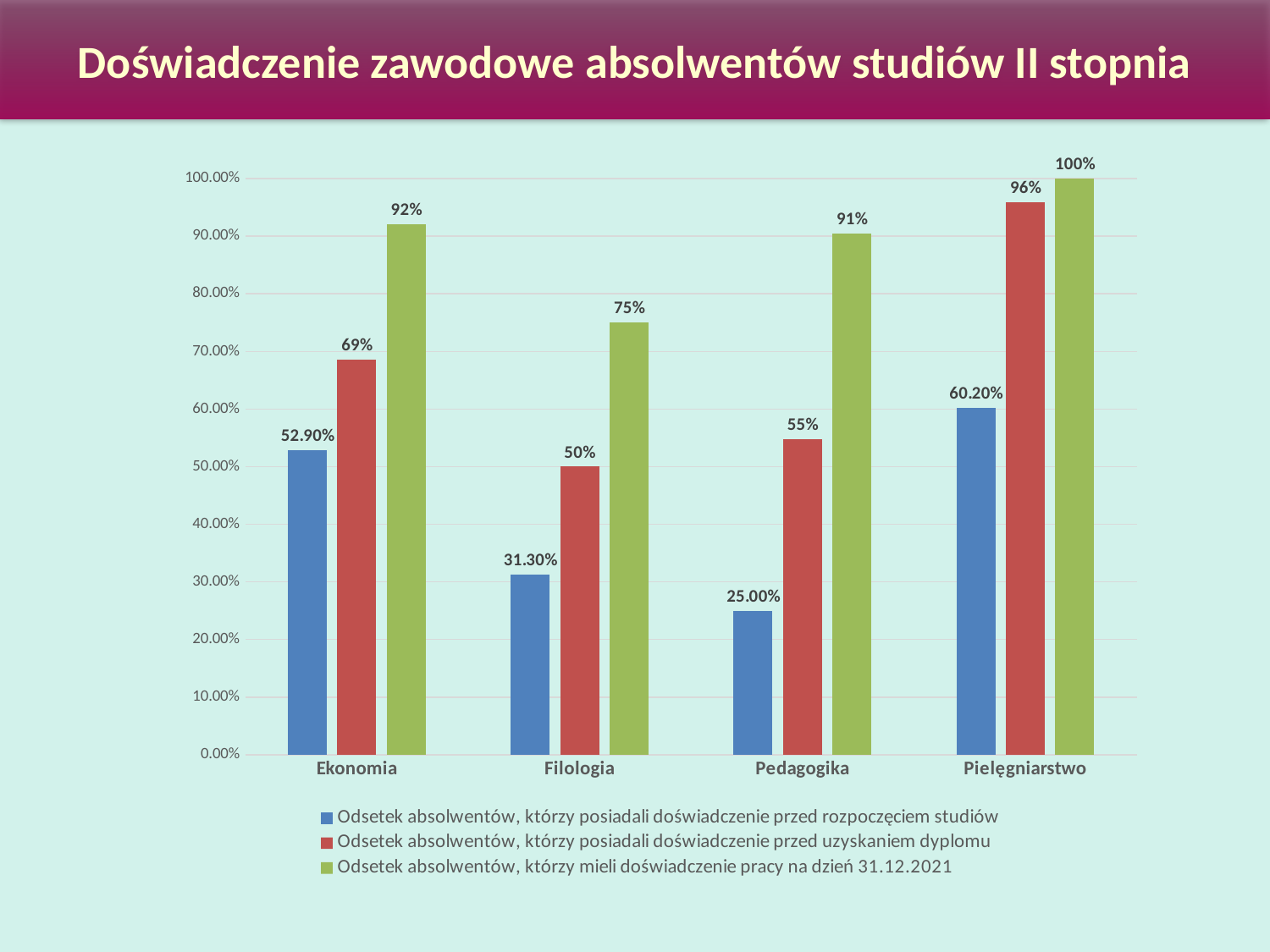
Which category has the highest value in the series 'Odsetek absolwentów, którzy posiadali doświadczenie przed uzyskaniem dyplomu'? Pielęgniarstwo How many categories are shown on the x axis? 4 What is the difference between the 'na dzień 31.12.2021' value and the 'przed uzyskaniem dyplomu' value for Ekonomia? 23 percentage points How many series does the legend list? 3 What is the difference between the 'przed rozpoczęciem studiów' values for Ekonomia and Filologia? 21.6 percentage points What is the value for Pedagogika in the series 'Odsetek absolwentów, którzy posiadali doświadczenie przed uzyskaniem dyplomu'? 55% What is the value for Ekonomia in the series 'Odsetek absolwentów, którzy posiadali doświadczenie przed rozpoczęciem studiów'? 52.90% What is the value for Pielęgniarstwo in the series 'Odsetek absolwentów, którzy mieli doświadczenie pracy na dzień 31.12.2021'? 100% Which is larger: the 'na dzień 31.12.2021' value for Filologia or for Pedagogika? Pedagogika Is the 'przed uzyskaniem dyplomu' value for Filologia greater or less than 60.00%? less What kind of chart is shown on the slide? bar chart Which category has the lowest value in the series 'Odsetek absolwentów, którzy posiadali doświadczenie przed rozpoczęciem studiów'? Pedagogika